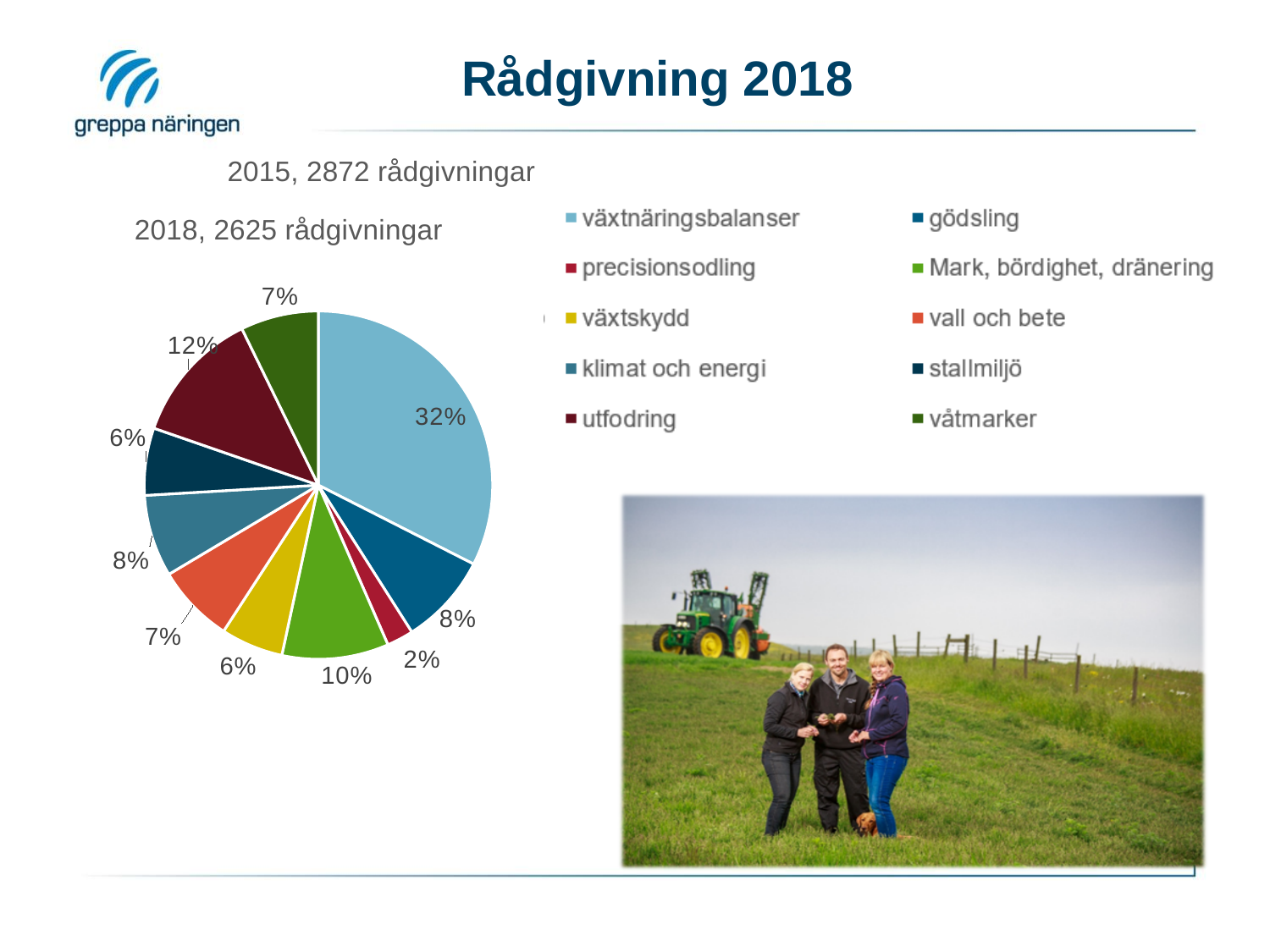
What share of the pie does växtnäringsbalanser have? 32% What is the value shown for precisionsodling? 2% Which category has the smallest share of the pie chart? precisionsodling What is the title of the slide containing the pie chart? Rådgivning 2018 Which is larger, the share for utfodring or the share for Mark, bördighet, dränering? utfodring What is the difference in percentage points between växtnäringsbalanser and utfodring? 20 How many slices does the pie chart have? 10 What is the value shown for Mark, bördighet, dränering? 10% What is the value shown for utfodring? 12% How many entries does the legend of the pie chart list? 10 Which category has the largest share of the pie chart? växtnäringsbalanser What kind of chart is shown on the slide? pie chart